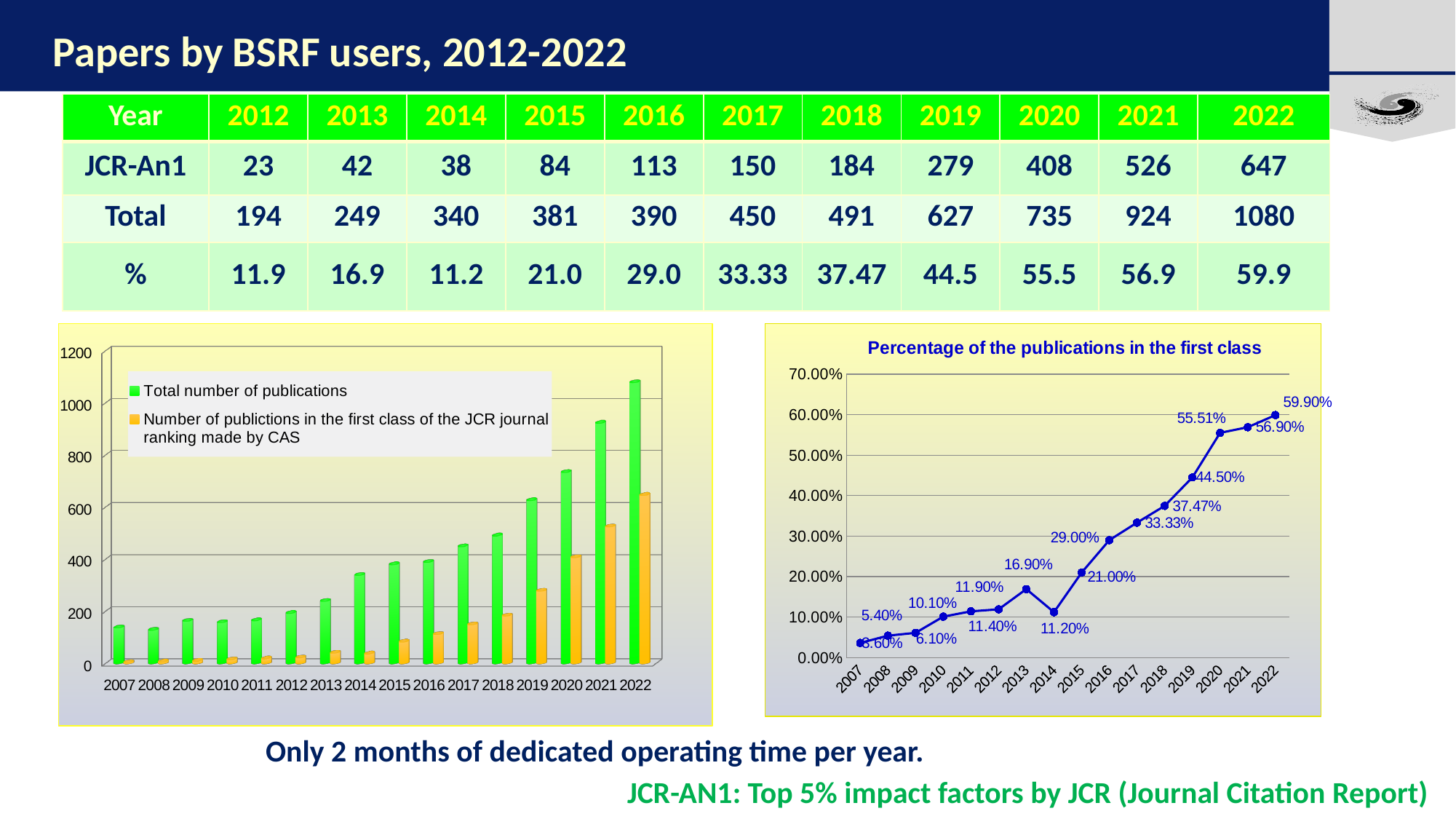
In the chart titled 'Percentage of the publications in the first class', which is larger, the value for 2013 or the value for 2014? 2013 In the chart titled 'Percentage of the publications in the first class', what is the value for 2022? 59.90% In the bar chart on the left, what colour are the bars for 'Total number of publications'? green In the chart titled 'Percentage of the publications in the first class', which year has the highest value? 2022 In the bar chart on the left, which year has the highest 'Total number of publications'? 2022 In the chart titled 'Percentage of the publications in the first class', how many years are plotted on the x axis? 16 In the bar chart on the left, is the value for 'Total number of publications' in 2022 greater or less than 1000? greater In the bar chart on the left, how many series does the legend list? 2 What kind of chart is the chart titled 'Percentage of the publications in the first class'? line chart In the chart titled 'Percentage of the publications in the first class', what is the difference between the values for 2020 and 2019? 11.01% In the chart titled 'Percentage of the publications in the first class', what is the value for 2018? 37.47% In the chart titled 'Percentage of the publications in the first class', what is the value for 2014? 11.20%